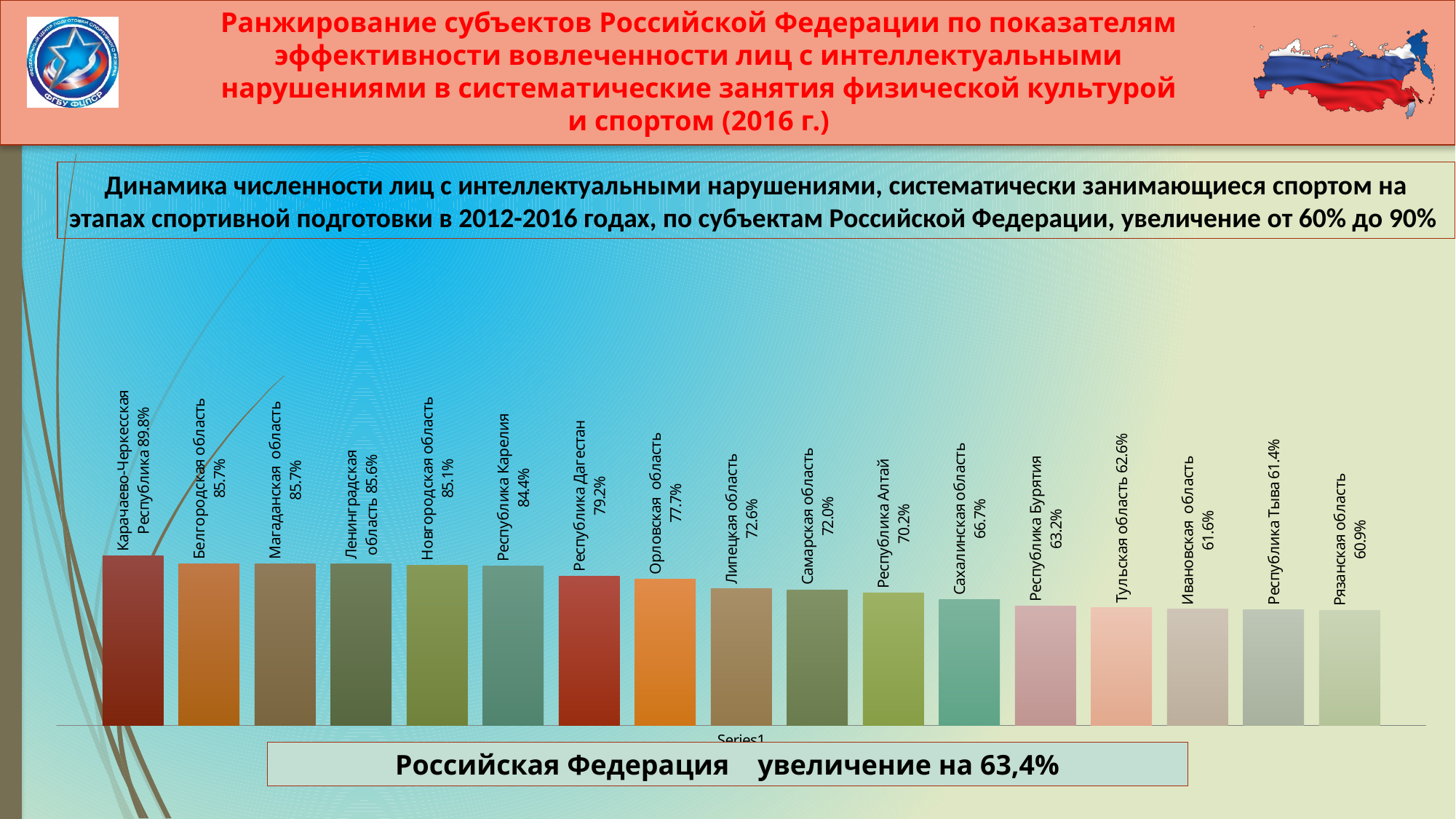
Which region has the lowest value in the chart? Рязанская область Do the values rise or fall from left to right across the chart? Fall What is the value shown for Карачаево-Черкесская Республика? 89.8% What kind of chart is shown on the slide? Bar chart What increase is stated for the Российская Федерация in the box below the chart? 63,4% Which region has the highest value in the chart? Карачаево-Черкесская Республика What is the difference between the values for Карачаево-Черкесская Республика and Рязанская область? 28.9 percentage points What is the value shown for Республика Дагестан? 79.2% How many regions (bars) are plotted in the chart? 17 What is the difference between the values for Республика Дагестан and Орловская область? 1.5 percentage points What is the value shown for Сахалинская область? 66.7% Which has a larger value, Липецкая область or Самарская область? Липецкая область